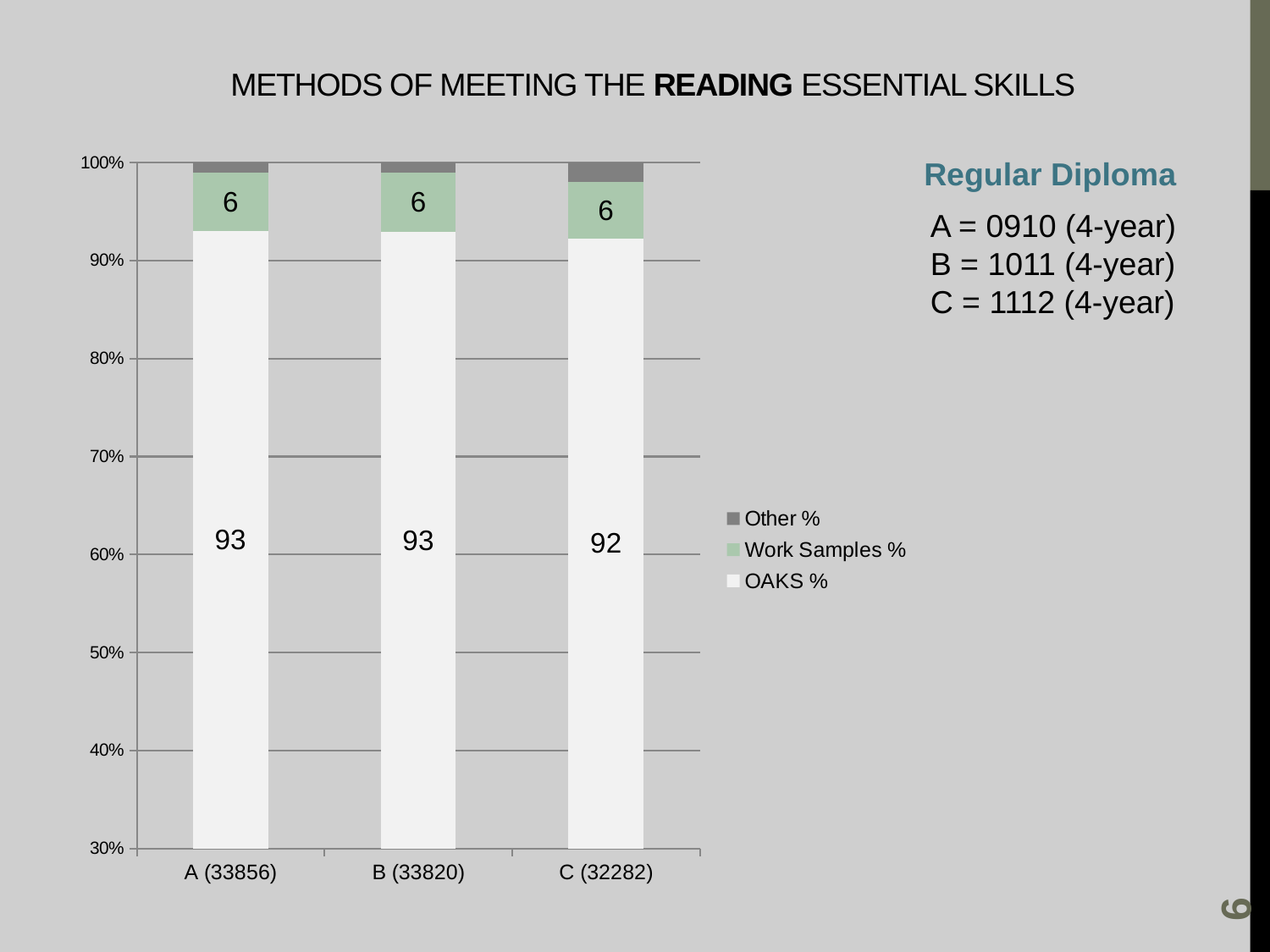
What is the title of the chart? METHODS OF MEETING THE READING ESSENTIAL SKILLS How many series does the legend list? 3 What is the difference between the OAKS % values for A (33856) and C (32282)? 1 What is the OAKS % value for category A (33856)? 93 Which series is shown in green in the legend? Work Samples % Does the OAKS % value rise or fall from A (33856) to C (32282)? fall What is the Work Samples % value for category B (33820)? 6 How many categories are shown on the x axis? 3 Which category has the lowest OAKS % value? C (32282) What kind of chart is shown on the slide? stacked bar chart What is the OAKS % value for category C (32282)? 92 Is the OAKS % value for B (33820) larger or smaller than the OAKS % value for C (32282)? larger